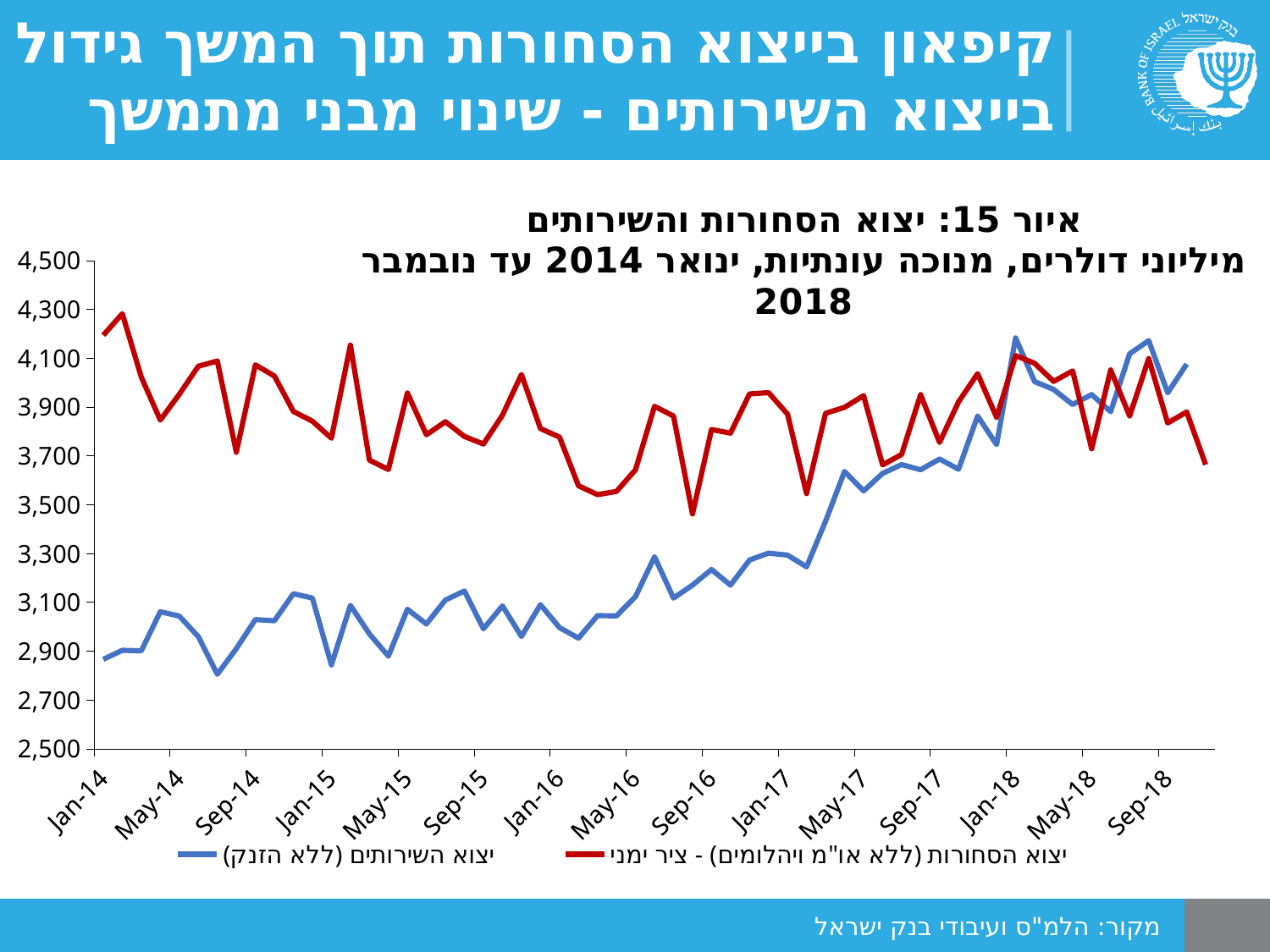
At Sep-16, which series has the higher value, the red (יצוא הסחורות) or the blue (יצוא השירותים)? red (יצוא הסחורות) How many series does the legend list? 2 At Jan-14, which series has the higher value, the red (יצוא הסחורות) or the blue (יצוא השירותים)? red (יצוא הסחורות) Does the blue series (יצוא השירותים) rise or fall overall from Jan-14 to Sep-18? rise Is the value of the blue series (יצוא השירותים) at Jan-18 greater or less than 3,900? greater Is the value of the red series (יצוא הסחורות) at Sep-16 greater or less than 3,700? greater Is the value of the blue series (יצוא השירותים) at Jan-14 greater or less than 3,100? less Which series is drawn in blue? יצוא השירותים (ללא הזנק) What kind of chart is shown on the slide? line chart What is the figure number given in the chart title? איור 15